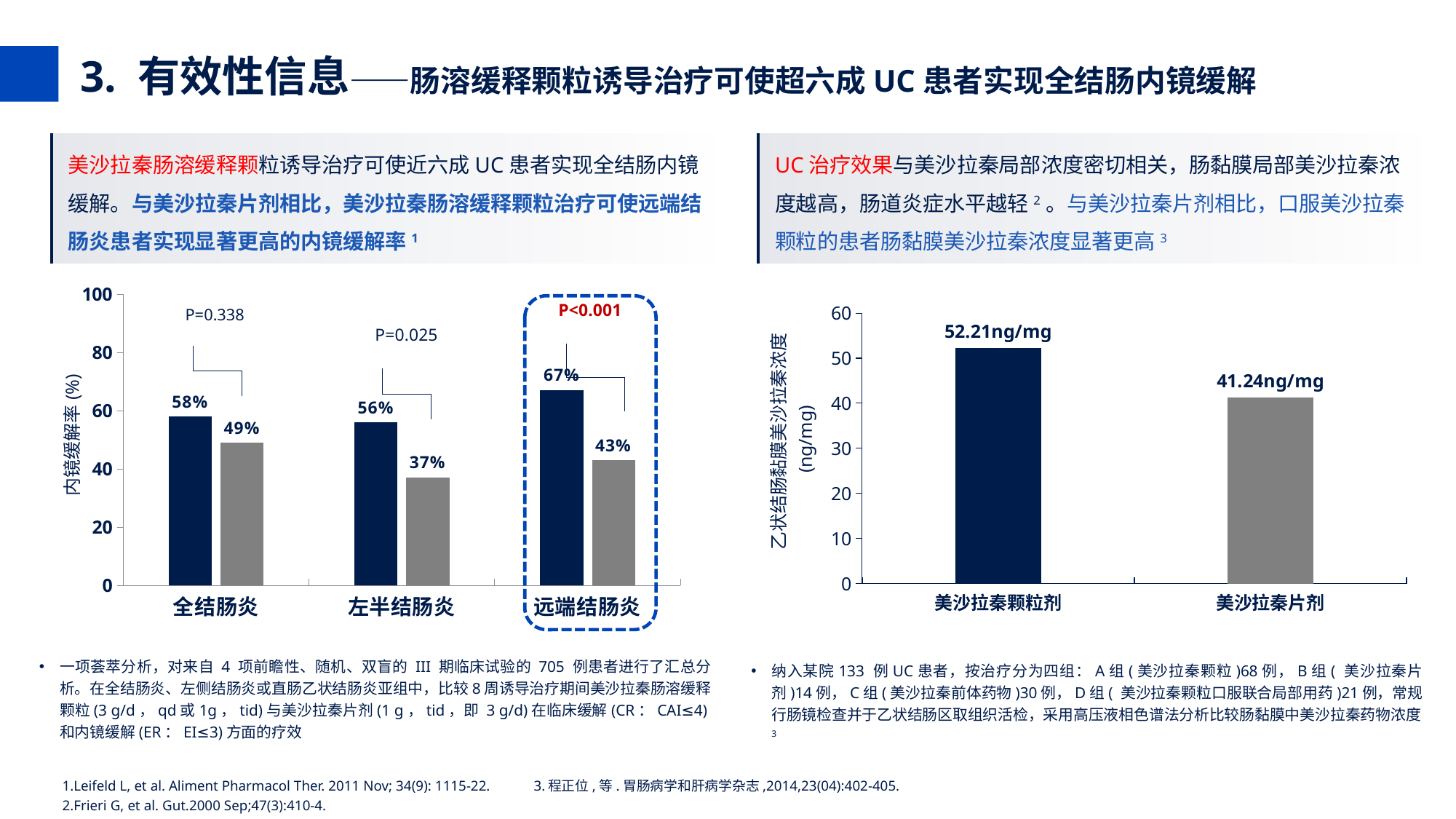
In the left chart (内镜缓解率), what P value is shown above the 远端结肠炎 bars? P<0.001 What kind of chart is the right chart? Bar chart In the right chart, what is the value for 美沙拉秦颗粒剂? 52.21ng/mg In the left chart (内镜缓解率), how many categories are shown on the x axis? 3 In the left chart (内镜缓解率), what is the value of the dark blue bar for 远端结肠炎? 67% In the left chart (内镜缓解率), what is the difference between the dark blue and gray bars for 远端结肠炎? 24% In the left chart (内镜缓解率), what is the value of the gray bar for 左半结肠炎? 37% In the left chart (内镜缓解率), which category has the highest dark blue bar? 远端结肠炎 In the right chart, which is larger, 美沙拉秦颗粒剂 or 美沙拉秦片剂? 美沙拉秦颗粒剂 In the left chart (内镜缓解率), which category has the lowest gray bar? 左半结肠炎 In the right chart, what is the value for 美沙拉秦片剂? 41.24ng/mg In the left chart (内镜缓解率), what is the value of the gray bar for 全结肠炎? 49%